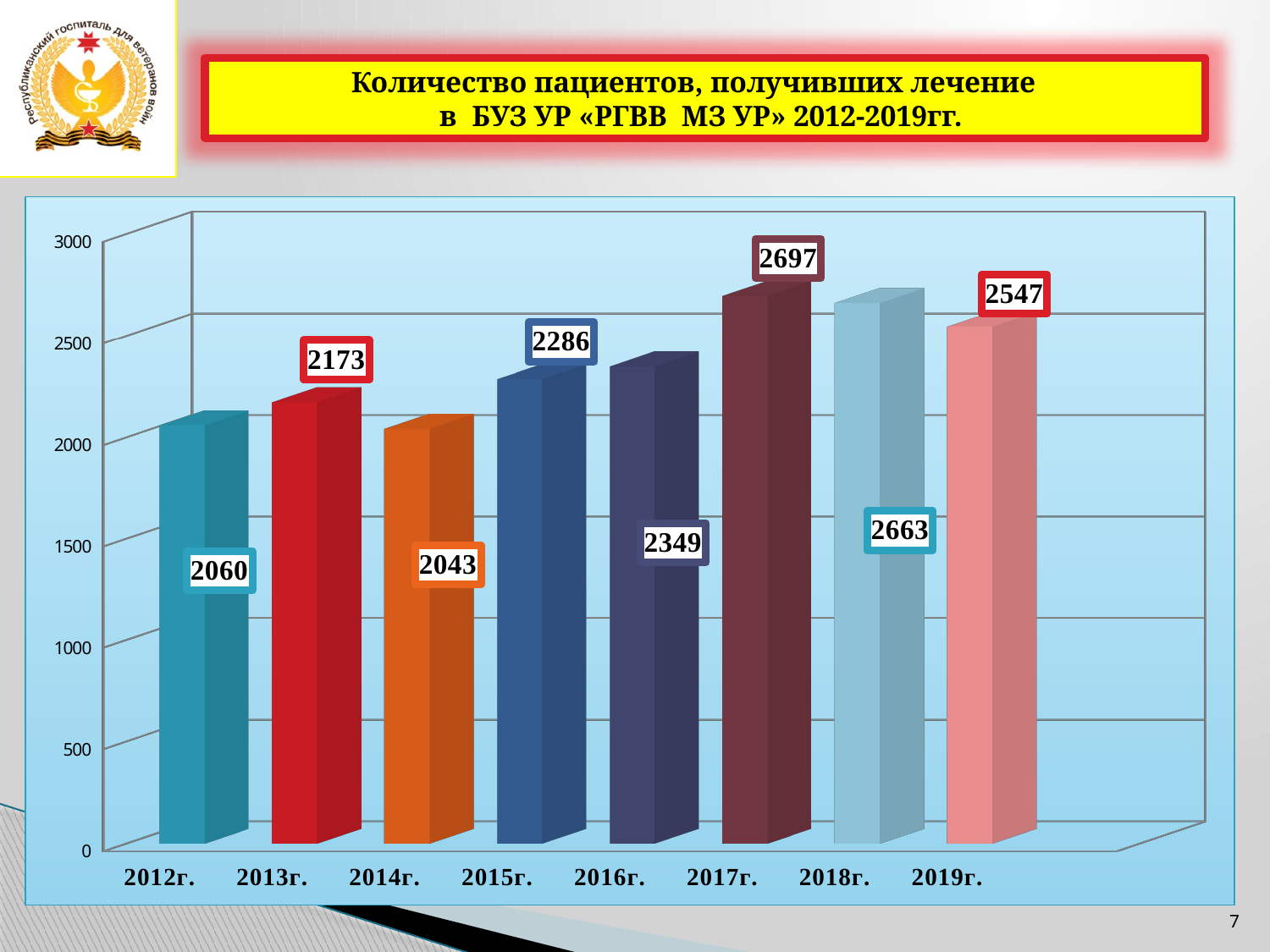
What was the number of patients treated in 2017г.? 2697 How many years are shown on the chart? 8 What is the difference between the number of patients in 2013г. and 2012г.? 113 Did the number of patients rise or fall from 2017г. to 2019г.? fall What kind of chart is shown on the slide? bar chart What was the number of patients treated in 2019г.? 2547 Which year had the lowest number of patients treated? 2014г. Is the value for 2015г. greater or less than 2000? greater What is the difference between the number of patients in 2017г. and 2018г.? 34 What was the number of patients treated in 2014г.? 2043 Which year had more patients treated, 2016г. or 2019г.? 2019г. Which year had the highest number of patients treated? 2017г.